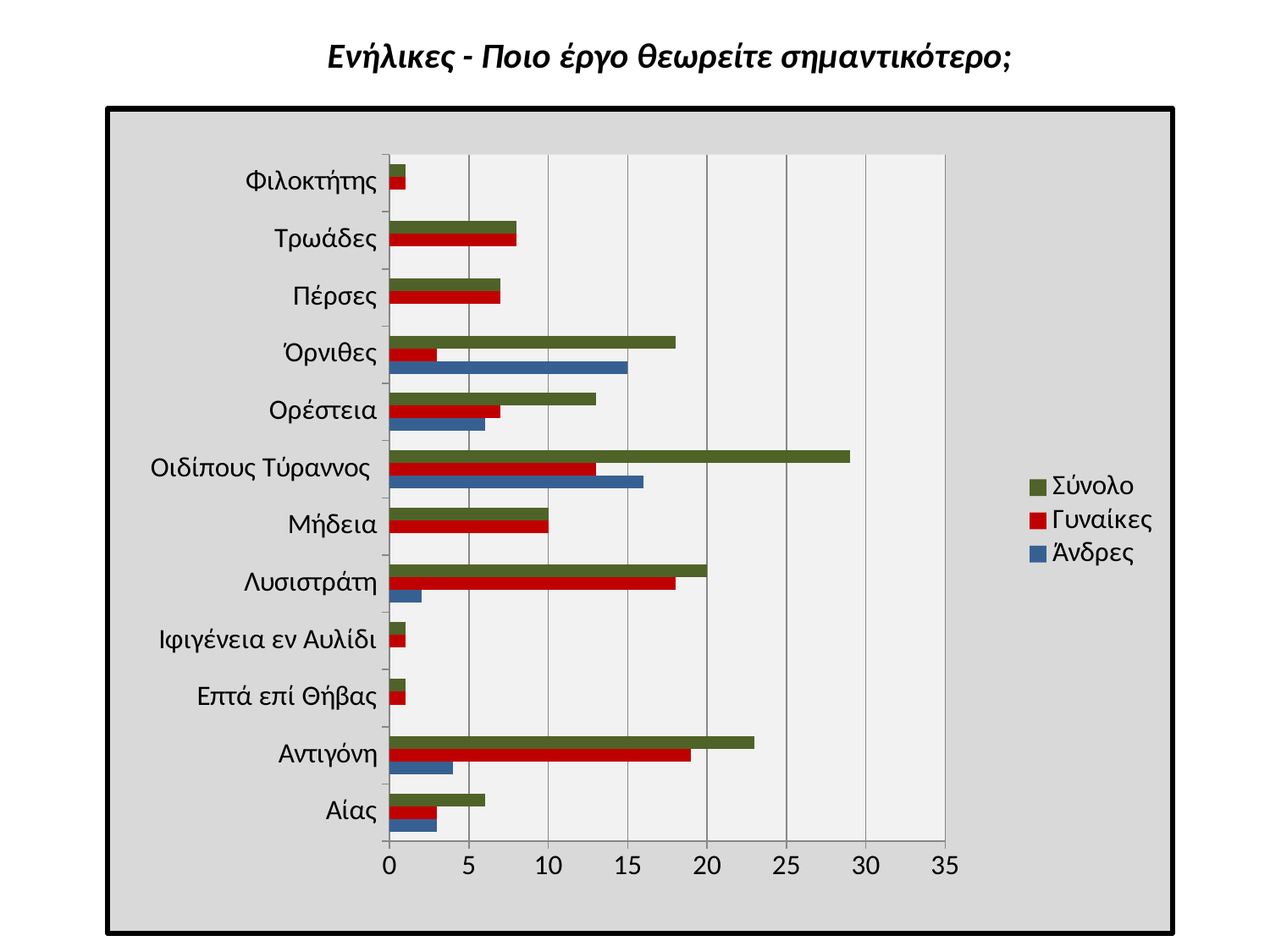
Is the Γυναίκες value for Αντιγόνη greater or less than 15? greater For Όρνιθες, which is larger: the Άνδρες value or the Γυναίκες value? Άνδρες For Λυσιστράτη, which is larger: the Γυναίκες value or the Άνδρες value? Γυναίκες What is the Σύνολο value for Λυσιστράτη? 20 What is the Σύνολο value for Μήδεια? 10 What colour represents the Σύνολο series in the legend? green Is the Σύνολο value for Οιδίπους Τύραννος greater or less than 25? greater How many series does the legend list? 3 Is the Σύνολο value for Ορέστεια greater or less than 10? greater How many plays (categories) are shown on the y axis? 12 Which play has the highest Σύνολο value? Οιδίπους Τύραννος What kind of chart is shown on the slide? bar chart